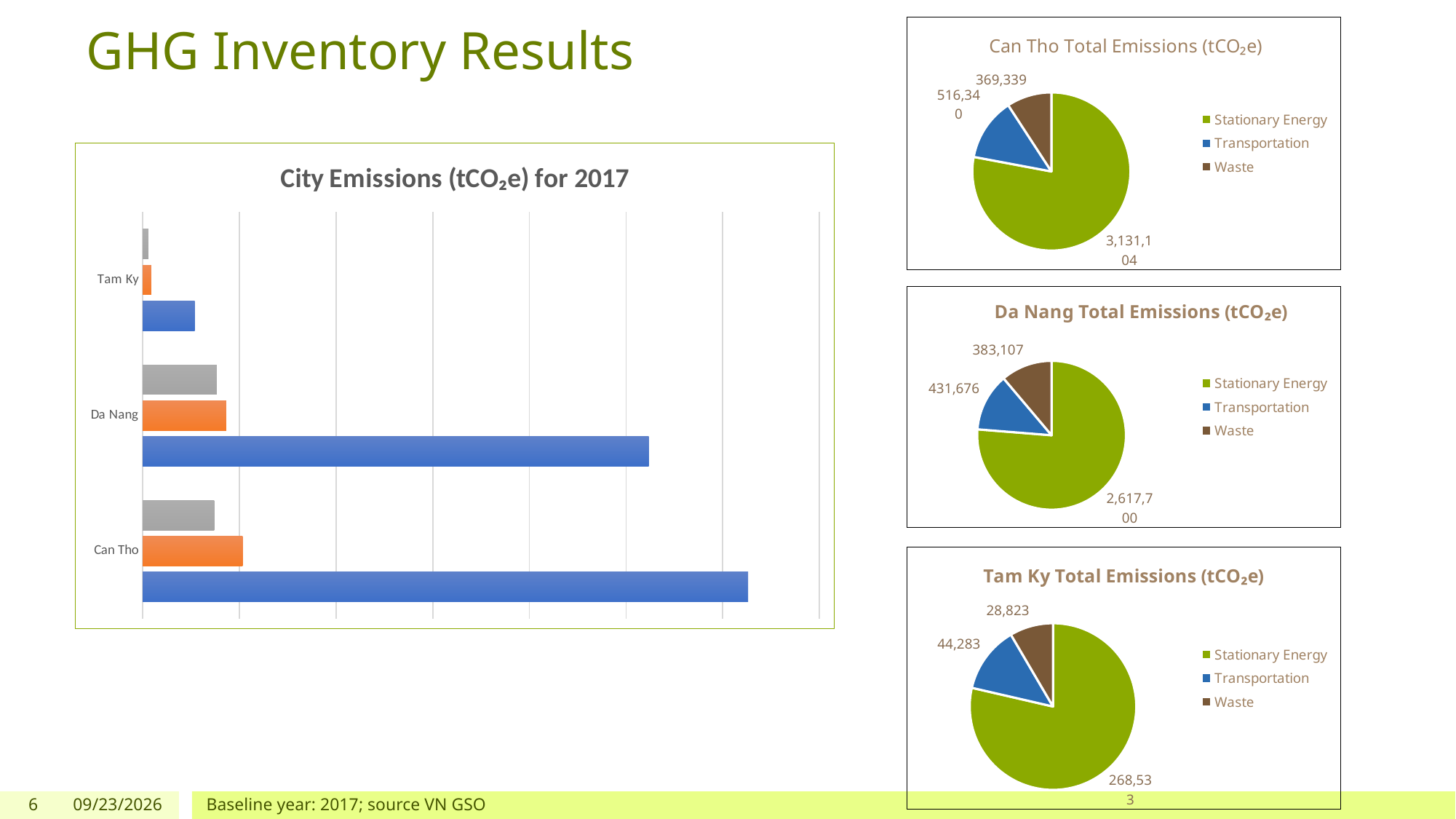
On the "City Emissions (tCO₂e) for 2017" bar chart, which city has the shortest bars overall? Tam Ky On the "Tam Ky Total Emissions (tCO₂e)" pie chart, which sector has the smallest slice? Waste On the "City Emissions (tCO₂e) for 2017" bar chart, which city has the longest blue bar? Can Tho On the "Tam Ky Total Emissions (tCO₂e)" pie chart, what is the difference between Transportation and Waste? 15,460 What kind of chart is the "City Emissions (tCO₂e) for 2017" chart on the left? bar chart On the "Da Nang Total Emissions (tCO₂e)" pie chart, what is the value for Waste? 383,107 On the "Can Tho Total Emissions (tCO₂e)" pie chart, what is the value for Transportation? 516,340 On the "Can Tho Total Emissions (tCO₂e)" pie chart, which is larger, Transportation or Waste? Transportation How many entries does the legend of the "Da Nang Total Emissions (tCO₂e)" pie chart list? 3 On the "Da Nang Total Emissions (tCO₂e)" pie chart, what is the difference between Transportation and Waste? 48,569 How many cities are shown on the "City Emissions (tCO₂e) for 2017" bar chart? 3 On the "Can Tho Total Emissions (tCO₂e)" pie chart, what is the value for Stationary Energy? 3,131,104